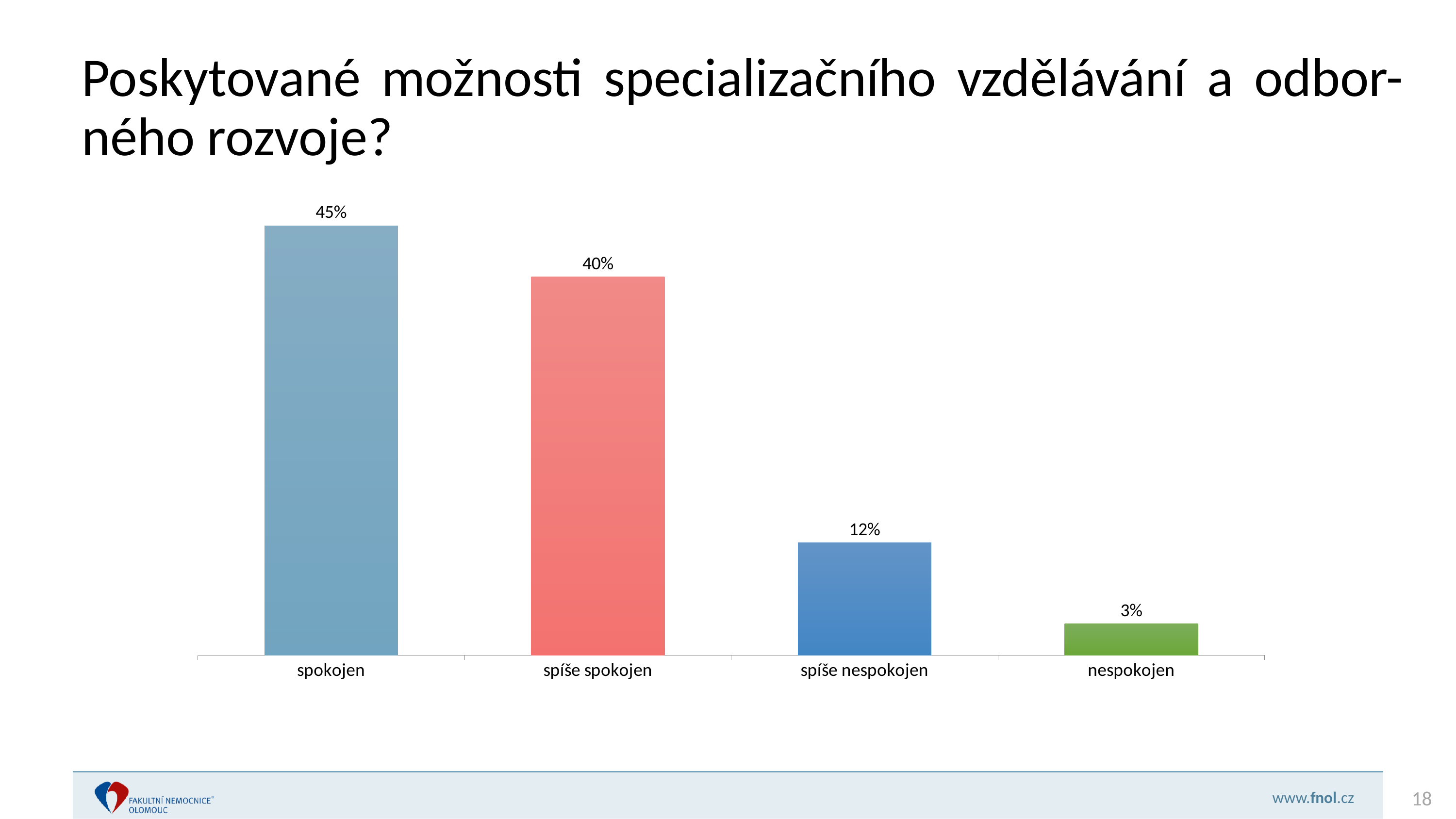
What is the value for "spíše nespokojen"? 12% What kind of chart is shown on the slide? bar chart What is the difference between the values for "spokojen" and "spíše spokojen"? 5% What is the difference between the values for "spíše nespokojen" and "nespokojen"? 9% What is the value for "spokojen"? 45% Do the values rise or fall from left to right along the x axis? fall Which is larger, the value for "spíše spokojen" or the value for "spíše nespokojen"? spíše spokojen What is the value for "spíše spokojen"? 40% What is the value for "nespokojen"? 3% How many categories are shown in the chart? 4 Which category has the lowest value? nespokojen Which category has the highest value? spokojen